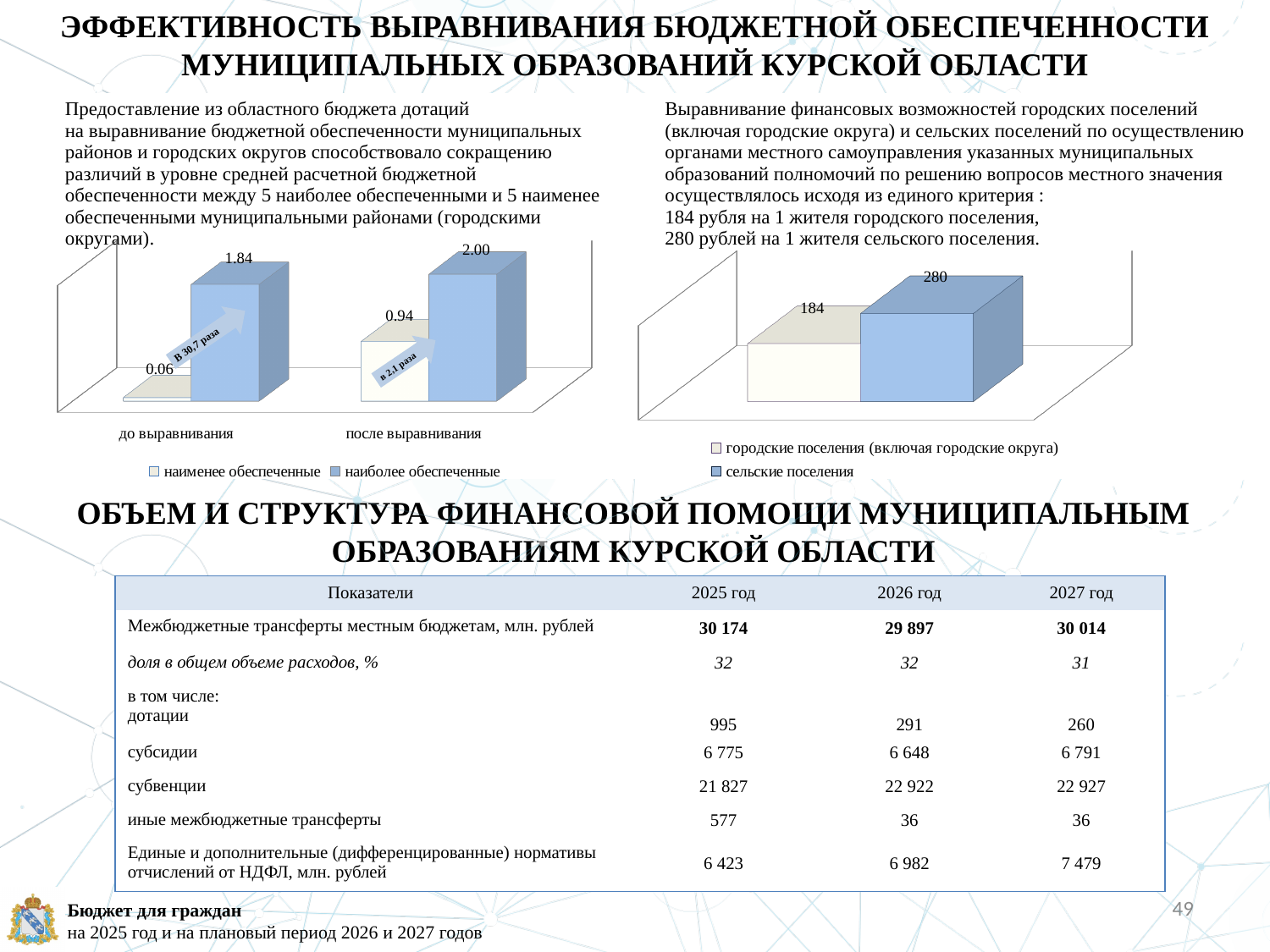
In the right chart, what is the value for городские поселения (включая городские округа)? 184 In the left chart, which series has the higher value до выравнивания? наиболее обеспеченные In the left chart, what is the difference between наиболее обеспеченные and наименее обеспеченные после выравнивания? 1.06 In the left chart, what is the value for наименее обеспеченные после выравнивания? 0.94 In the right chart, what is the value for сельские поселения? 280 In the left chart, what is the value for наиболее обеспеченные после выравнивания? 2.00 In the left chart, how many series does the legend list? 2 In the right chart, what is the difference between сельские поселения and городские поселения (включая городские округа)? 96 In the left chart, how many categories are shown on the x axis? 2 In the left chart, what is the value for наименее обеспеченные до выравнивания? 0.06 What kind of chart is the right chart? bar chart In the left chart, what is the value for наиболее обеспеченные до выравнивания? 1.84